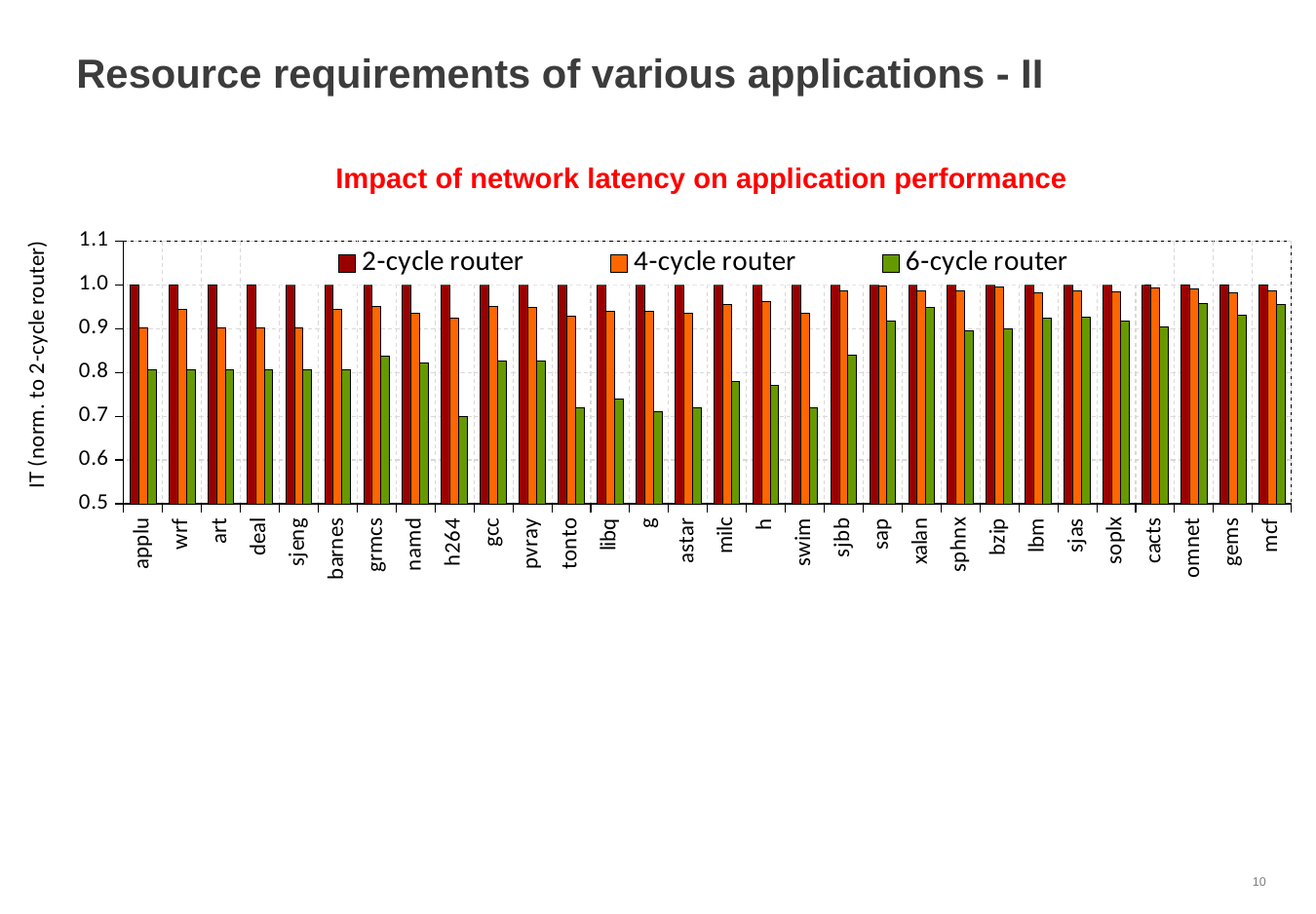
What is the label on the y axis? IT (norm. to 2-cycle router) Which is larger for swim: the 4-cycle router value or the 6-cycle router value? 4-cycle router Is the 6-cycle router value for swim greater or less than 0.8? less Is the 6-cycle router value for xalan greater or less than 0.9? greater How many series does the legend list? 3 Which application has the larger 6-cycle router value, swim or xalan? xalan How many applications (categories) are shown on the x axis? 30 What kind of chart is shown on the slide? bar chart What is the title of the chart? Impact of network latency on application performance Is the 6-cycle router value for sjbb greater or less than 0.9? less What is the value of the 2-cycle router bar for applu? 1.0